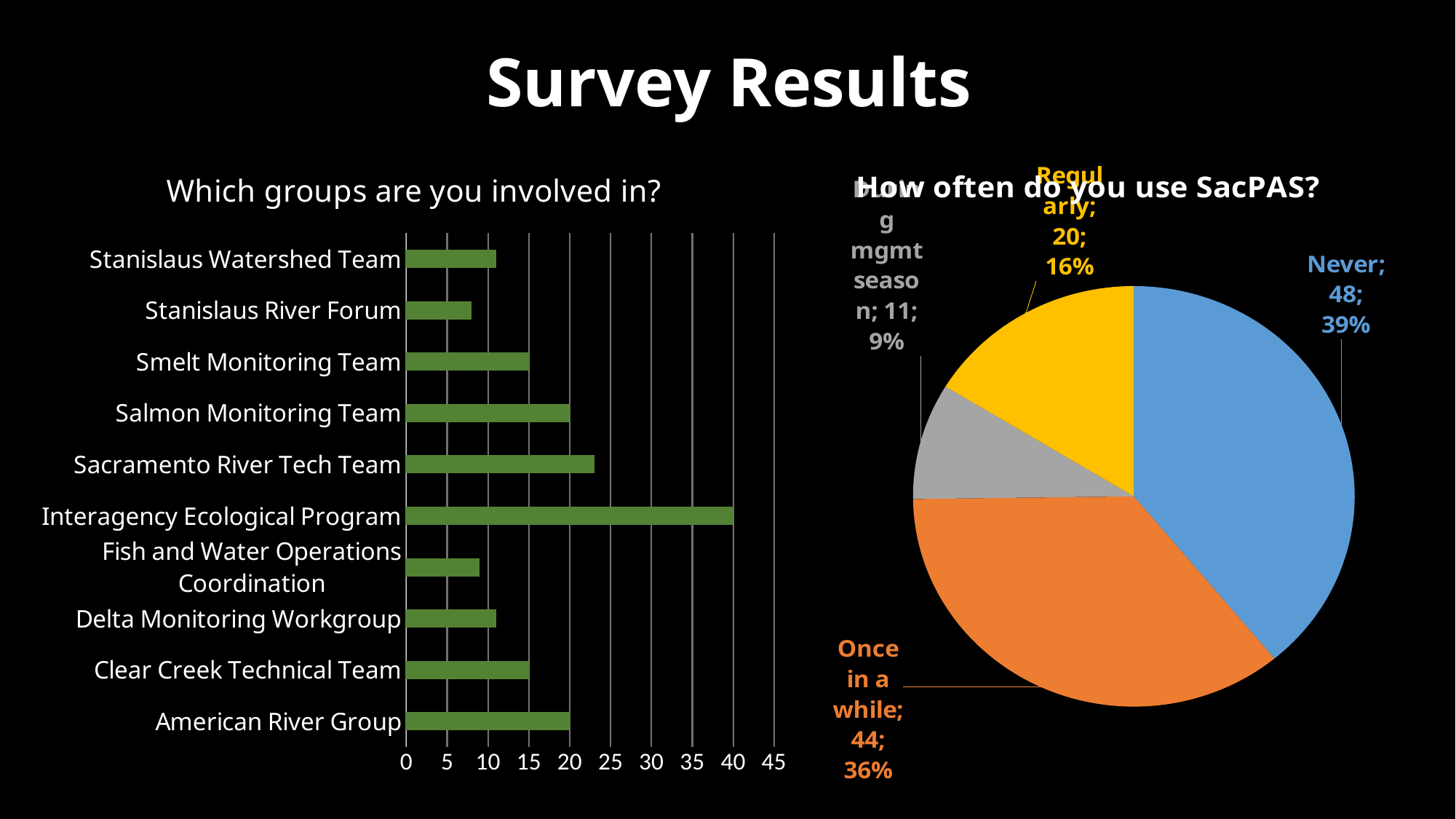
In the 'How often do you use SacPAS?' chart, how many respondents answered 'Never'? 48 In the 'How often do you use SacPAS?' chart, what share of the pie is 'Once in a while'? 36% In the 'Which groups are you involved in?' chart, is the value for Stanislaus River Forum greater or less than 10? less In the 'Which groups are you involved in?' chart, what is the value for Interagency Ecological Program? 40 How many groups are listed in the 'Which groups are you involved in?' chart? 10 In the 'Which groups are you involved in?' chart, which is larger: Salmon Monitoring Team or Stanislaus Watershed Team? Salmon Monitoring Team What kind of chart is the 'Which groups are you involved in?' chart? bar chart In the 'Which groups are you involved in?' chart, is the value for Sacramento River Tech Team greater or less than 20? greater What kind of chart is the 'How often do you use SacPAS?' chart? pie chart In the 'How often do you use SacPAS?' chart, what is the difference between the 'Never' count and the 'Once in a while' count? 4 In the 'Which groups are you involved in?' chart, which group has the highest value? Interagency Ecological Program In the 'How often do you use SacPAS?' chart, which response has the largest slice? Never